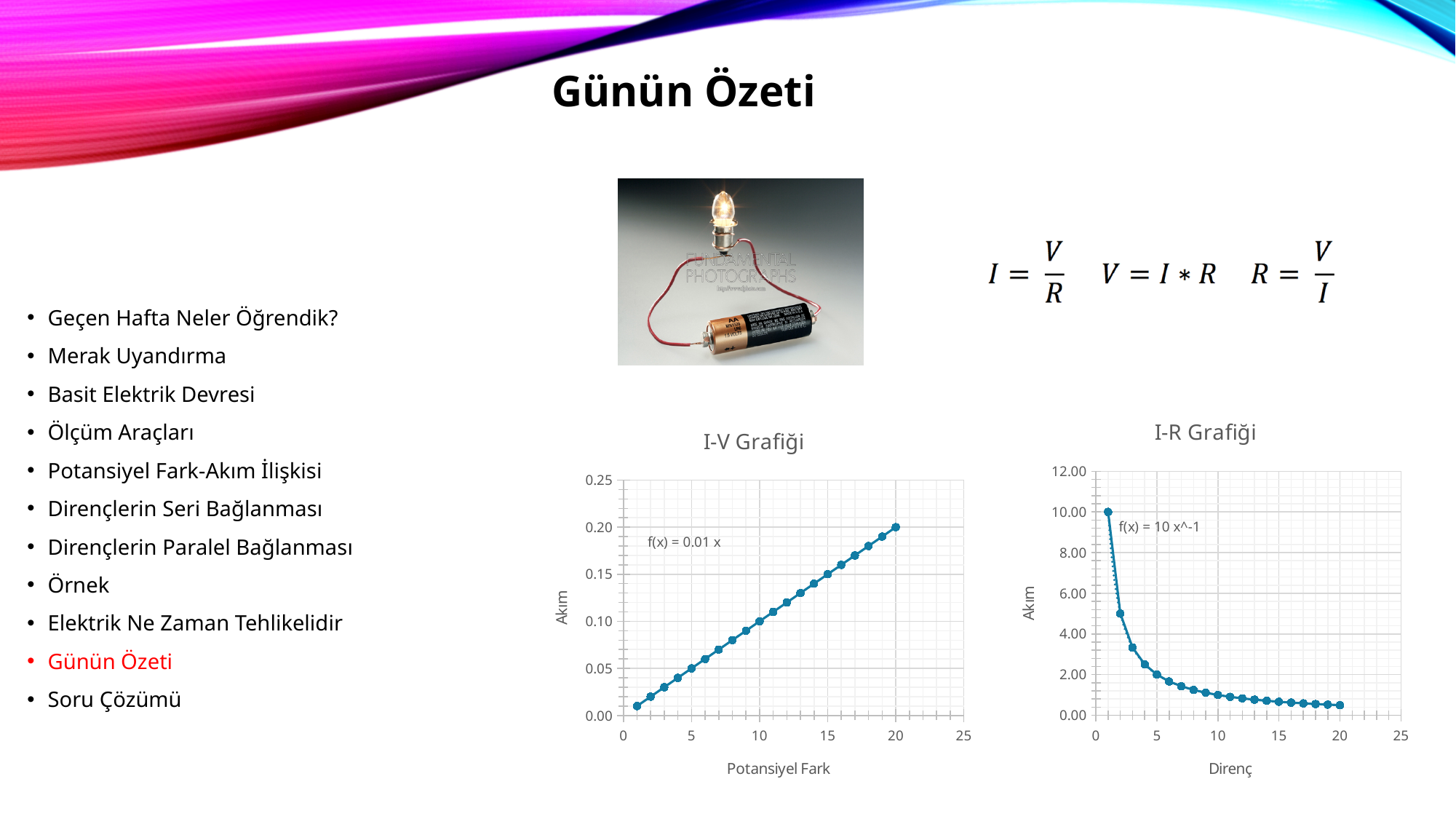
In the I-V Grafiği chart, do the values rise or fall as Potansiyel Fark increases? Rise In the I-R Grafiği chart, what is the x-axis label? Direnç In the I-R Grafiği chart, what is the Akım value when Direnç is 5? 2.00 What is the title of the chart on the left? I-V Grafiği In the I-R Grafiği chart, what is the Akım value when Direnç is 1? 10.00 What kind of chart is the I-V Grafiği chart? Line chart with markers In the I-V Grafiği chart, is the Akım value at Potansiyel Fark 18 greater or less than 0.15? greater In the I-V Grafiği chart, what is the Akım value when Potansiyel Fark is 10? 0.10 In the I-R Grafiği chart, is the Akım value at Direnç 20 greater or less than 2.00? less In the I-R Grafiği chart, do the values rise or fall as Direnç increases? Fall In the I-V Grafiği chart, what is the Akım value when Potansiyel Fark is 20? 0.20 In the I-R Grafiği chart, which Direnç value has the highest Akım? 1